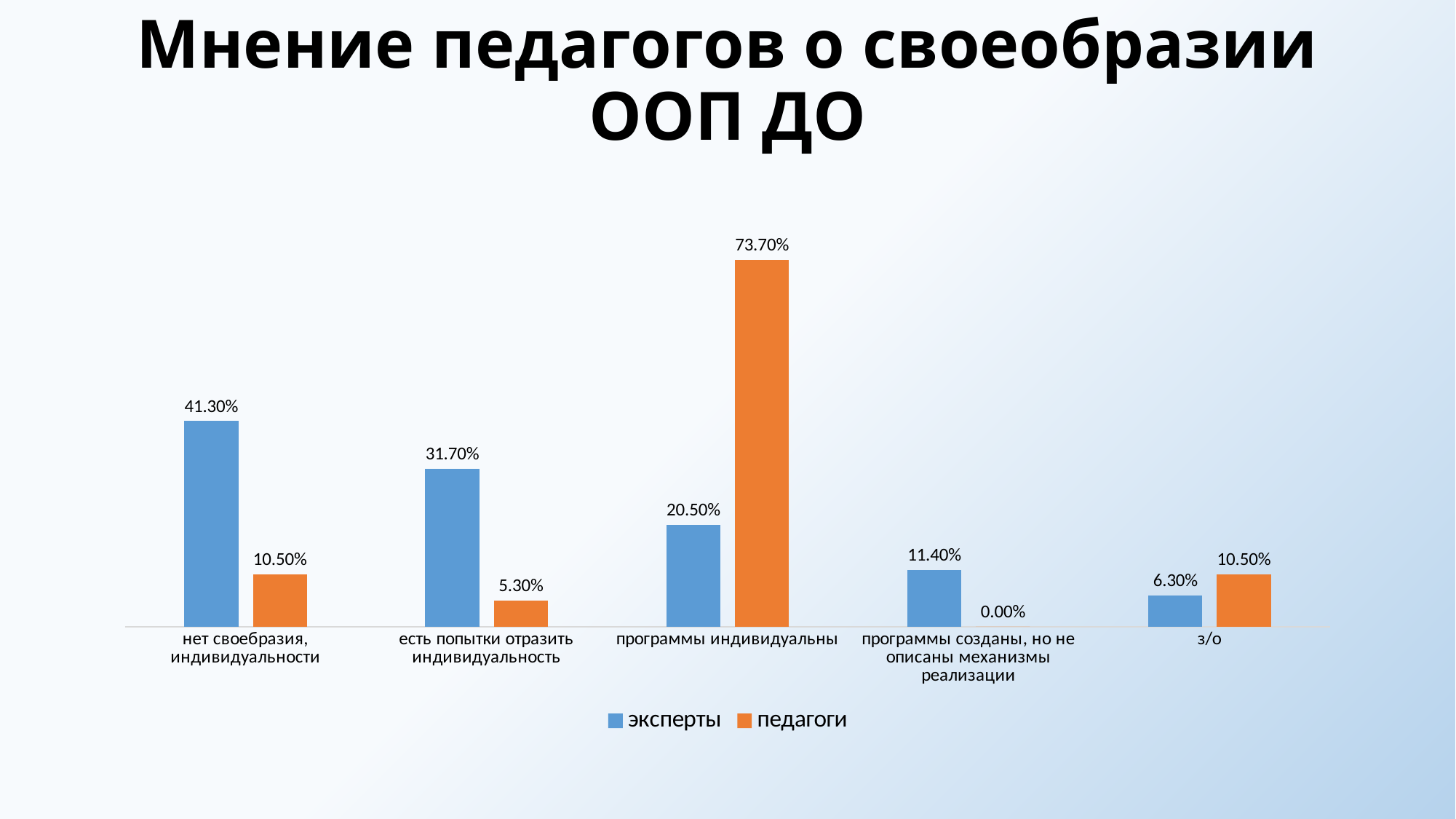
What is the value for эксперты in the category 'нет своебразия, индивидуальности'? 41.30% Which is larger in the category 'з/о': the value for эксперты or for педагоги? педагоги Which category has the highest value for эксперты? нет своебразия, индивидуальности What kind of chart is shown on the slide? bar chart What is the value for педагоги in the category 'программы индивидуальны'? 73.70% What is the value for педагоги in the category 'есть попытки отразить индивидуальность'? 5.30% What is the value for эксперты in the category 'з/о'? 6.30% Which category has the lowest value for педагоги? программы созданы, но не описаны механизмы реализации How many series does the legend list? 2 Which category has the highest value for педагоги? программы индивидуальны How many categories are shown on the x axis? 5 What is the difference between the педагоги and эксперты values in the category 'программы индивидуальны'? 53.20%